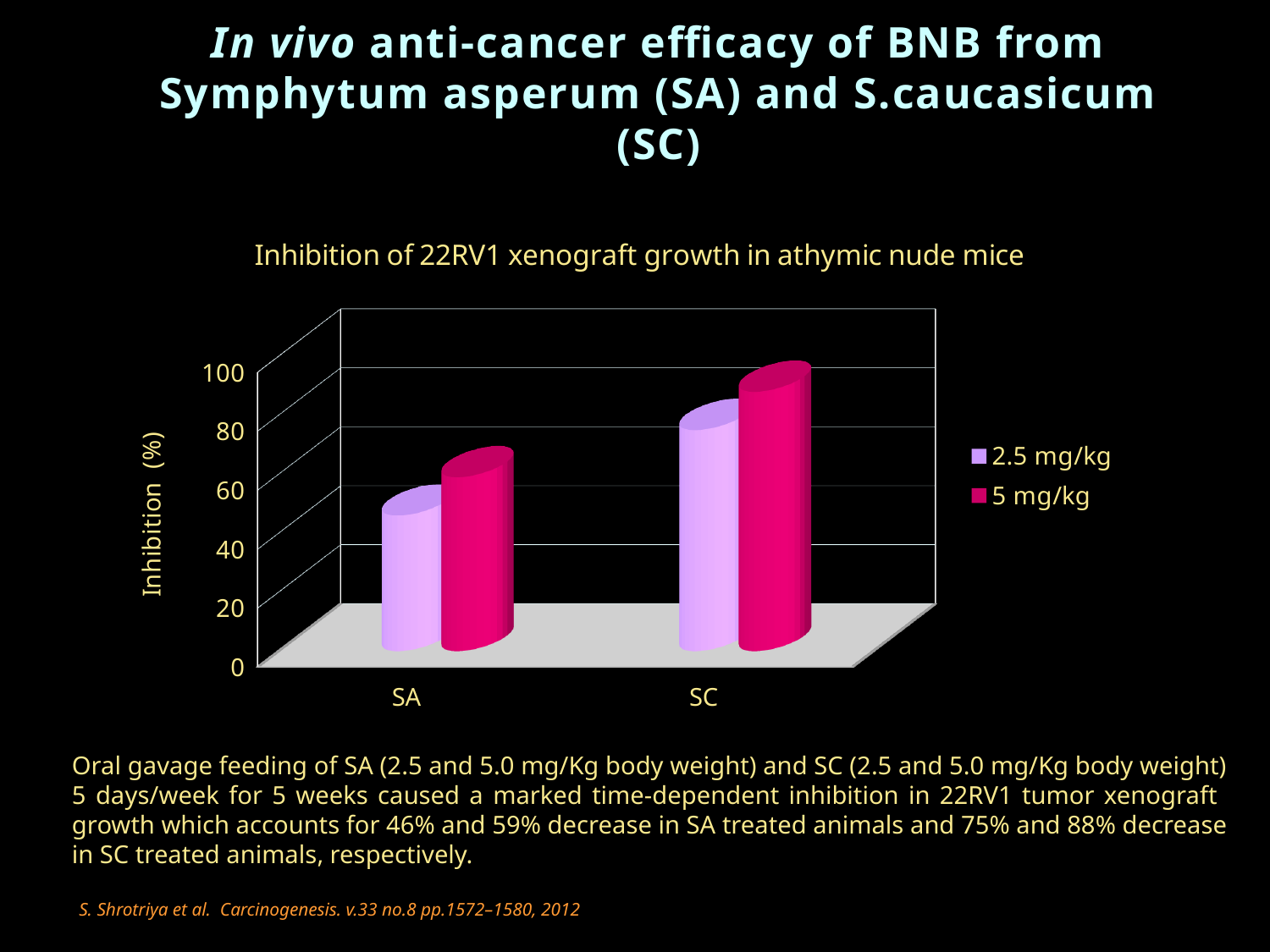
Which bar is the shortest in the chart? SA at 2.5 mg/kg According to the slide text, what percentage decrease in tumor growth was seen in SA-treated animals at 5 mg/kg? 59% What kind of chart is shown on the slide? Bar chart According to the slide text, what percentage decrease in tumor growth was seen in SC-treated animals at 2.5 mg/kg? 75% What is the label on the vertical axis of the chart? Inhibition (%) How many series does the legend list in the chart? 2 Is the value for SC at 5 mg/kg greater or less than 80? greater Is the value for SA at 2.5 mg/kg greater or less than 60? less Using the percentages given in the slide text, how much greater is the inhibition for SC than for SA at 5 mg/kg? 29 percentage points Which is larger: the 2.5 mg/kg bar for SC or the 5 mg/kg bar for SA? 2.5 mg/kg bar for SC Which bar is the tallest in the chart? SC at 5 mg/kg How many categories are shown on the x axis of the chart? 2